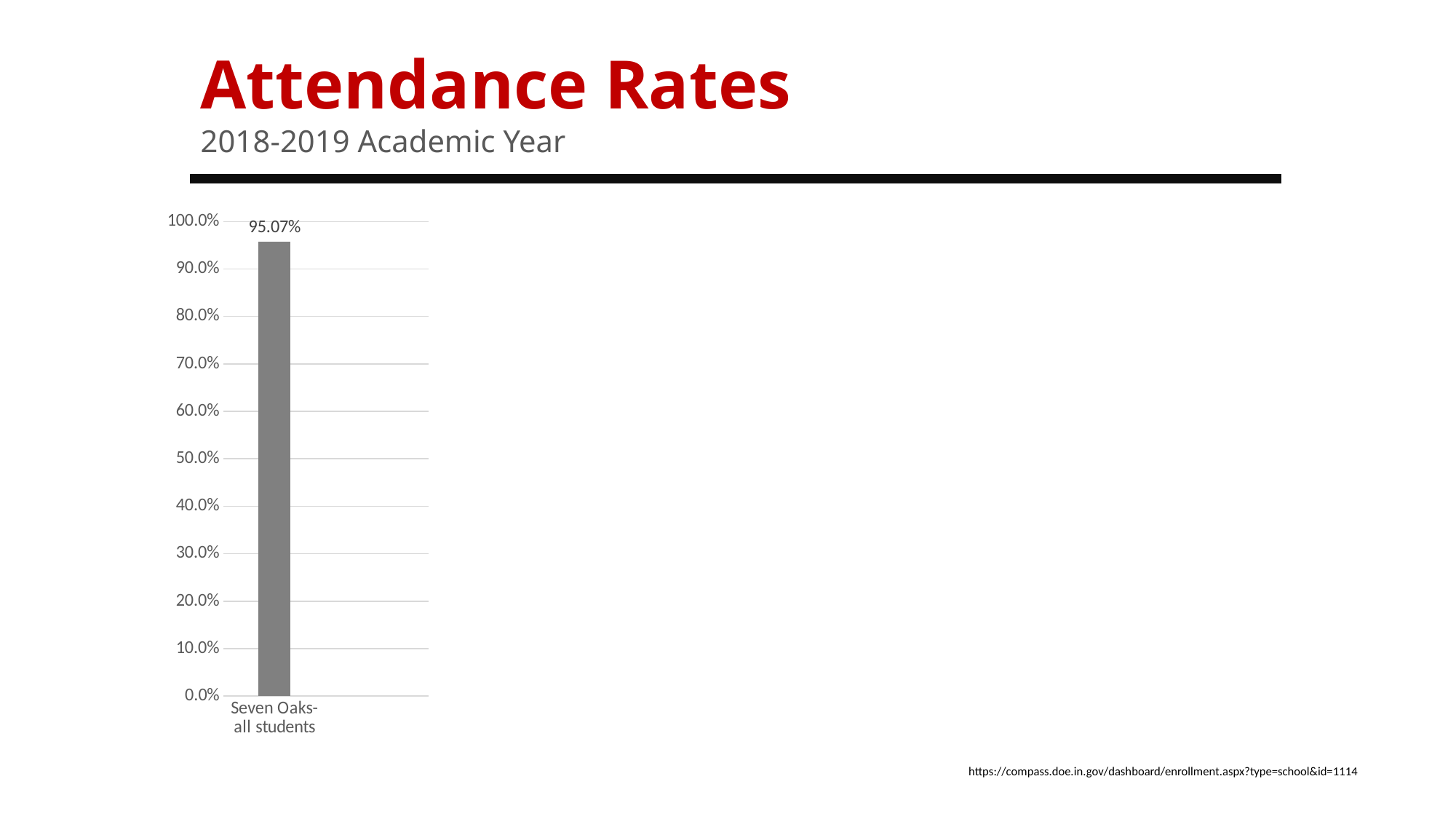
Is the value for Seven Oaks- all students greater or less than 100.0%? less What is the label of the only category on the x axis of the chart? Seven Oaks- all students What kind of chart is shown on the slide? bar chart Is the value for Seven Oaks- all students greater or less than 90.0%? greater How many categories are plotted in the chart? 1 What is the highest value shown on the chart's y axis? 100.0% What is the attendance rate shown for Seven Oaks- all students? 95.07%